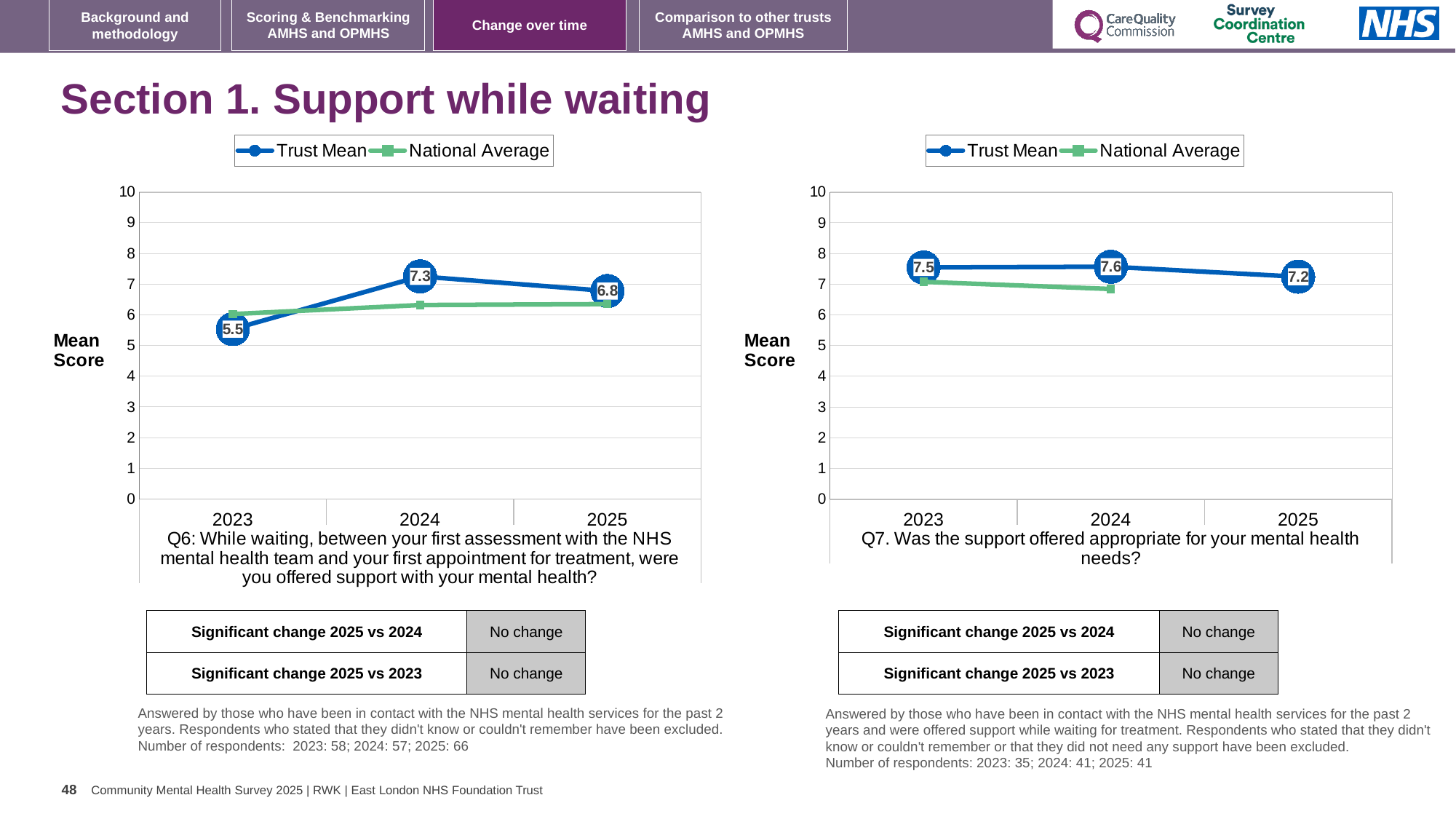
In the Q6 chart on the left, what is the Trust Mean score for 2024? 7.3 In the Q6 chart on the left, is the National Average for 2023 greater or less than 5? greater In the Q7 chart on the right, what is the difference between the Trust Mean scores for 2023 and 2025? 0.3 In the Q6 chart on the left, what is the Trust Mean score for 2023? 5.5 How many series does the legend of the Q7 chart on the right list? 2 In the Q6 chart on the left, which year has the lowest Trust Mean score? 2023 In the Q7 chart on the right, what is the Trust Mean score for 2025? 7.2 In the Q6 chart on the left, what is the difference between the Trust Mean scores for 2024 and 2023? 1.8 In the Q6 chart on the left, what is the Trust Mean score for 2025? 6.8 In the Q7 chart on the right, what is the Trust Mean score for 2024? 7.6 In the Q7 chart on the right, is the Trust Mean for 2023 larger or smaller than the National Average for 2023? larger In the Q6 chart on the left, which year has the highest Trust Mean score? 2024